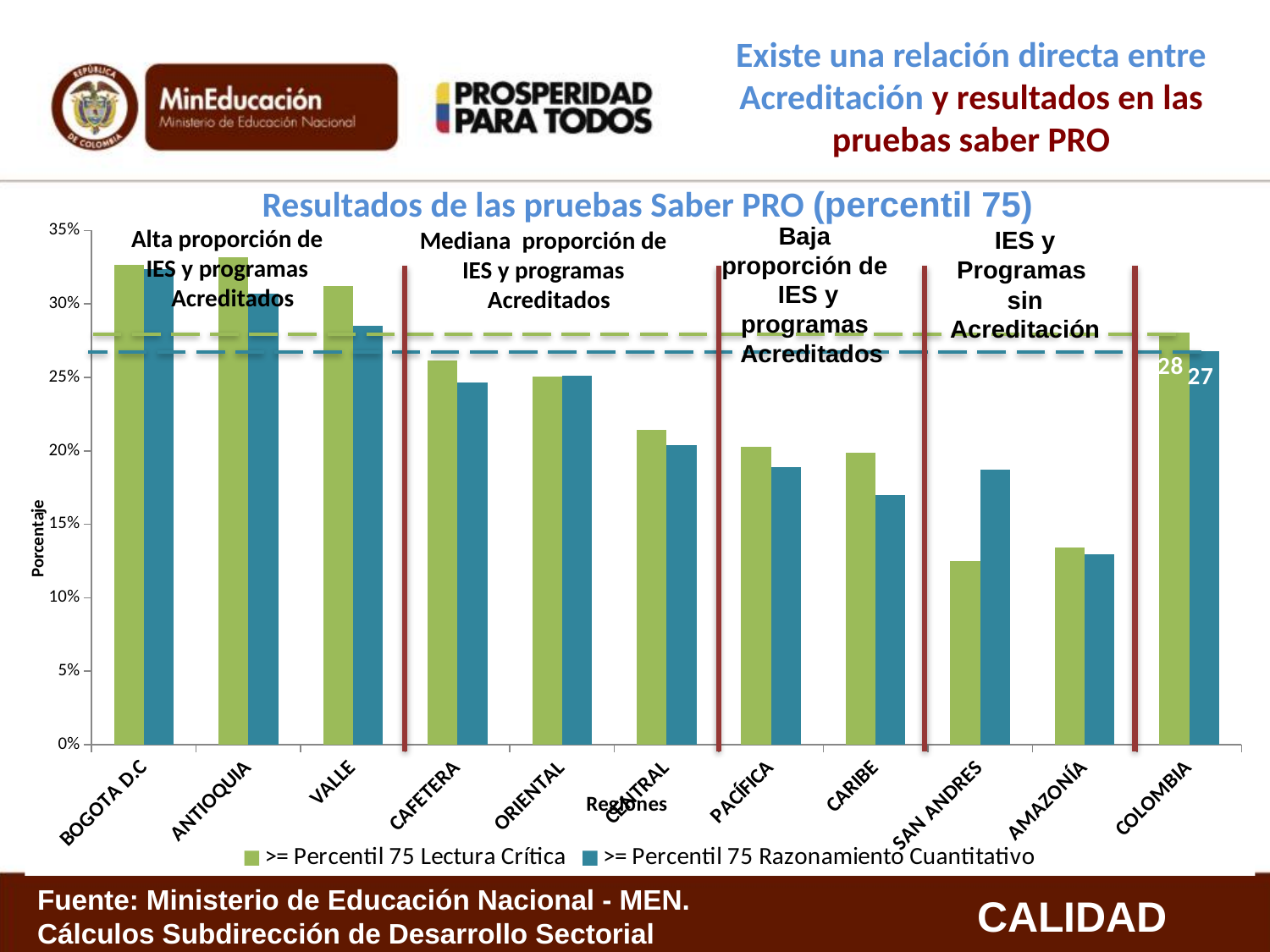
Which region has the lowest value in the '>= Percentil 75 Razonamiento Cuantitativo' series? AMAZONÍA What is the title of the chart? Resultados de las pruebas Saber PRO (percentil 75) What is the difference between the two COLOMBIA values (Lectura Crítica minus Razonamiento Cuantitativo)? 1 Which region has the highest value in the '>= Percentil 75 Razonamiento Cuantitativo' series? BOGOTA D.C Is the '>= Percentil 75 Razonamiento Cuantitativo' value for CARIBE greater or less than 20%? less How many series does the legend list? 2 What kind of chart is shown on the slide? bar chart What is the value for COLOMBIA in the '>= Percentil 75 Razonamiento Cuantitativo' series? 27 For SAN ANDRES, which series has the larger value: Lectura Crítica or Razonamiento Cuantitativo? Razonamiento Cuantitativo Is the '>= Percentil 75 Lectura Crítica' value for BOGOTA D.C greater or less than 30%? greater How many regions (categories) are shown on the x axis? 11 What is the value for COLOMBIA in the '>= Percentil 75 Lectura Crítica' series? 28